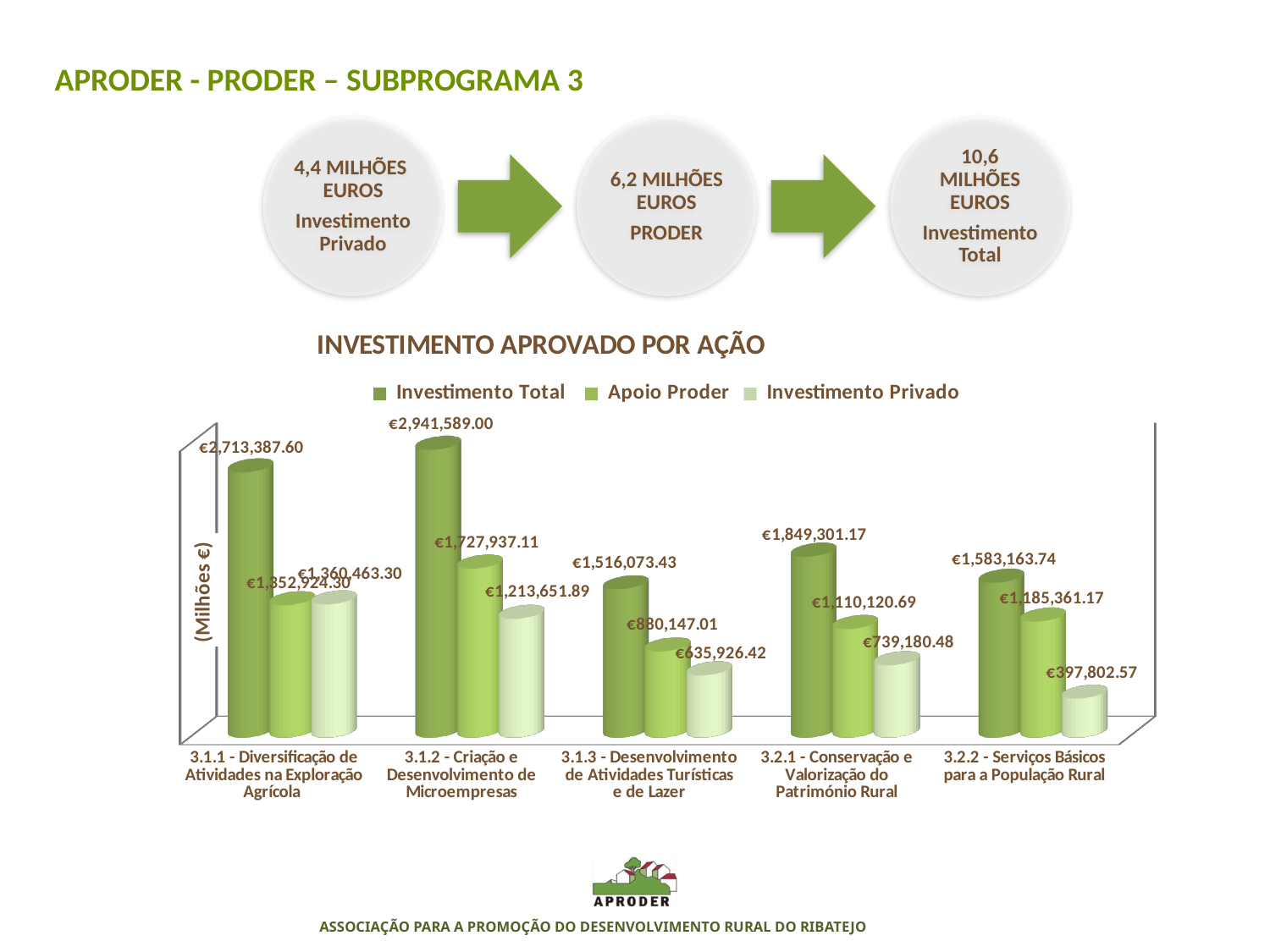
How many actions (categories) are shown on the x axis of the chart? 5 What is the difference between Apoio Proder and Investimento Privado for 3.1.3 - Desenvolvimento de Atividades Turísticas e de Lazer? €244,220.59 What is the Investimento Total value for 3.1.3 - Desenvolvimento de Atividades Turísticas e de Lazer? €1,516,073.43 Which has the larger Apoio Proder value: 3.2.1 - Conservação e Valorização do Património Rural or 3.2.2 - Serviços Básicos para a População Rural? 3.2.2 - Serviços Básicos para a População Rural Which action has the highest Investimento Total? 3.1.2 - Criação e Desenvolvimento de Microempresas Which action has the lowest Investimento Total? 3.1.3 - Desenvolvimento de Atividades Turísticas e de Lazer Which action has the lowest Investimento Privado? 3.2.2 - Serviços Básicos para a População Rural What is the Investimento Total value for 3.1.2 - Criação e Desenvolvimento de Microempresas? €2,941,589.00 What is the Apoio Proder value for 3.2.1 - Conservação e Valorização do Património Rural? €1,110,120.69 What type of chart is used to show Investimento Aprovado por Ação? Bar chart What is the Investimento Privado value for 3.2.2 - Serviços Básicos para a População Rural? €397,802.57 How many series does the chart legend list? 3